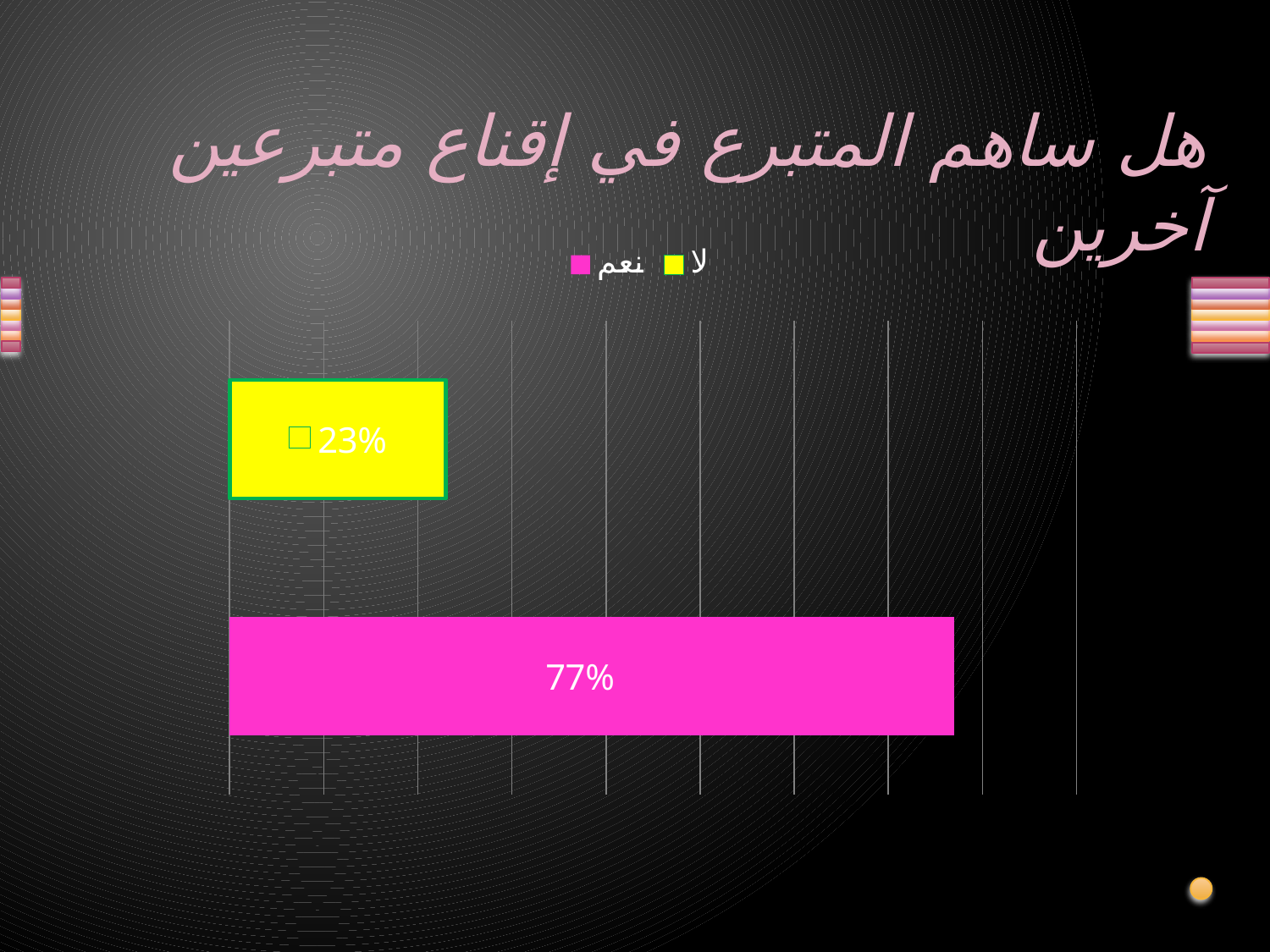
How many entries does the legend list? 2 What colour is the bar for نعم? Magenta What is the value for لا? 23% How many bars are plotted in the chart? 2 Which is larger, the value for نعم or the value for لا? نعم What is the difference between the values for نعم and لا? 54% What is the value for نعم? 77% What kind of chart is shown on the slide? Bar chart Which category has the highest value? نعم What colour is the bar for لا? Yellow Which category has the lowest value? لا What is the total of the two values shown in the chart? 100%